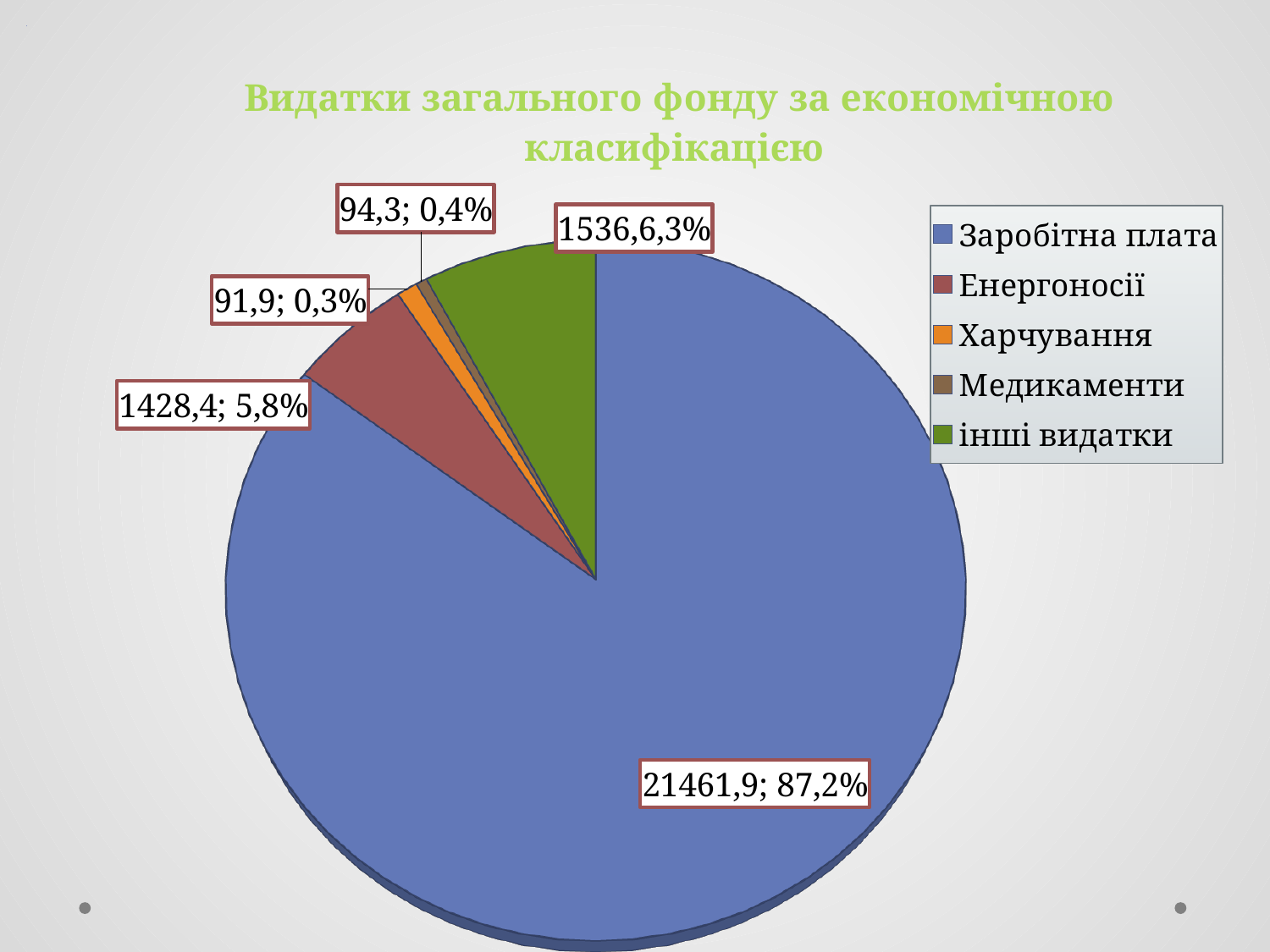
What is the value shown for Заробітна плата? 21461,9 What kind of chart is shown on the slide? pie chart How many slices does the pie chart have? 5 What share of the pie does Енергоносії represent? 5,8% What colour is the slice for Заробітна плата? blue How many entries does the legend list? 5 Which category has the largest slice of the pie? Заробітна плата What is the value shown for інші видатки? 1536 What share of the pie does Заробітна плата represent? 87,2% What is the value shown for Енергоносії? 1428,4 What is the title of the chart? Видатки загального фонду за економічною класифікацією Which is larger, Енергоносії or інші видатки? інші видатки